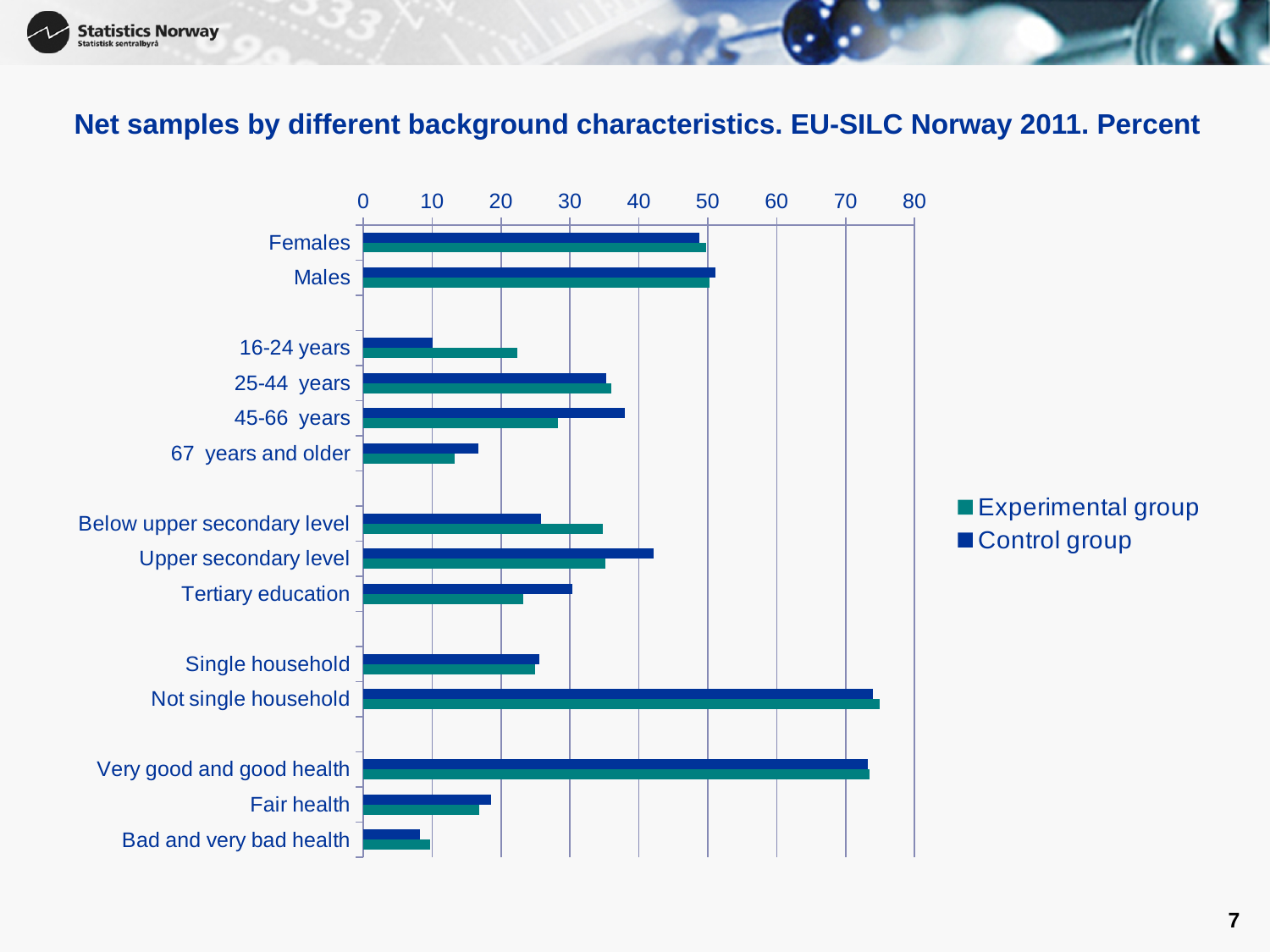
Is the Experimental group value for Tertiary education greater or less than 30? less How many series does the legend list? 2 Is the Experimental group value for 16-24 years greater or less than 20? greater Is the Control group value for Not single household greater or less than 70? greater What kind of chart is shown on the slide? bar chart How many categories are plotted on the vertical axis of the chart? 14 For 45-66 years, which series has the larger value, Experimental group or Control group? Control group For Upper secondary level, which series has the larger value, Experimental group or Control group? Control group For Below upper secondary level, which series has the larger value, Experimental group or Control group? Experimental group Among the four age groups, which has the highest Control group value? 45-66 years Among the three health categories, which has the lowest Experimental group value? Bad and very bad health